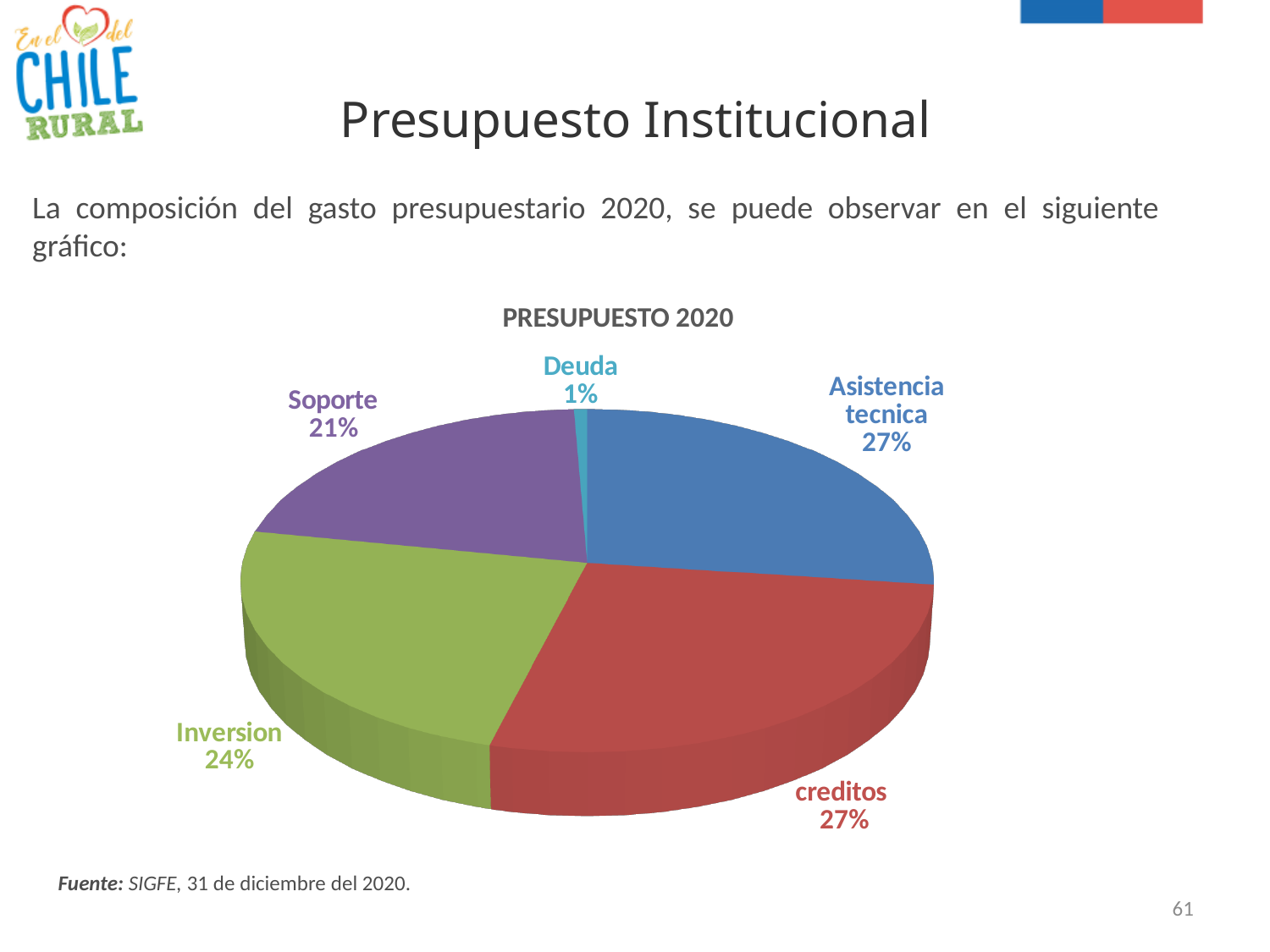
What is the share for Inversion in the PRESUPUESTO 2020 pie chart? 24% What is the difference in percentage points between Inversion and Soporte? 3 Which category has the smallest slice in the pie chart? Deuda Which is larger, the share for creditos or the share for Inversion? creditos How many categories are shown in the pie chart? 5 What is the share labelled for Deuda? 1% What is the title of the chart? PRESUPUESTO 2020 Which is larger, the share for Inversion or the share for Soporte? Inversion What percentage does Soporte represent in the pie chart? 21% What is the difference in percentage points between creditos and Deuda? 26 What percentage is shown for Asistencia tecnica? 27% What type of chart is shown on the slide? Pie chart